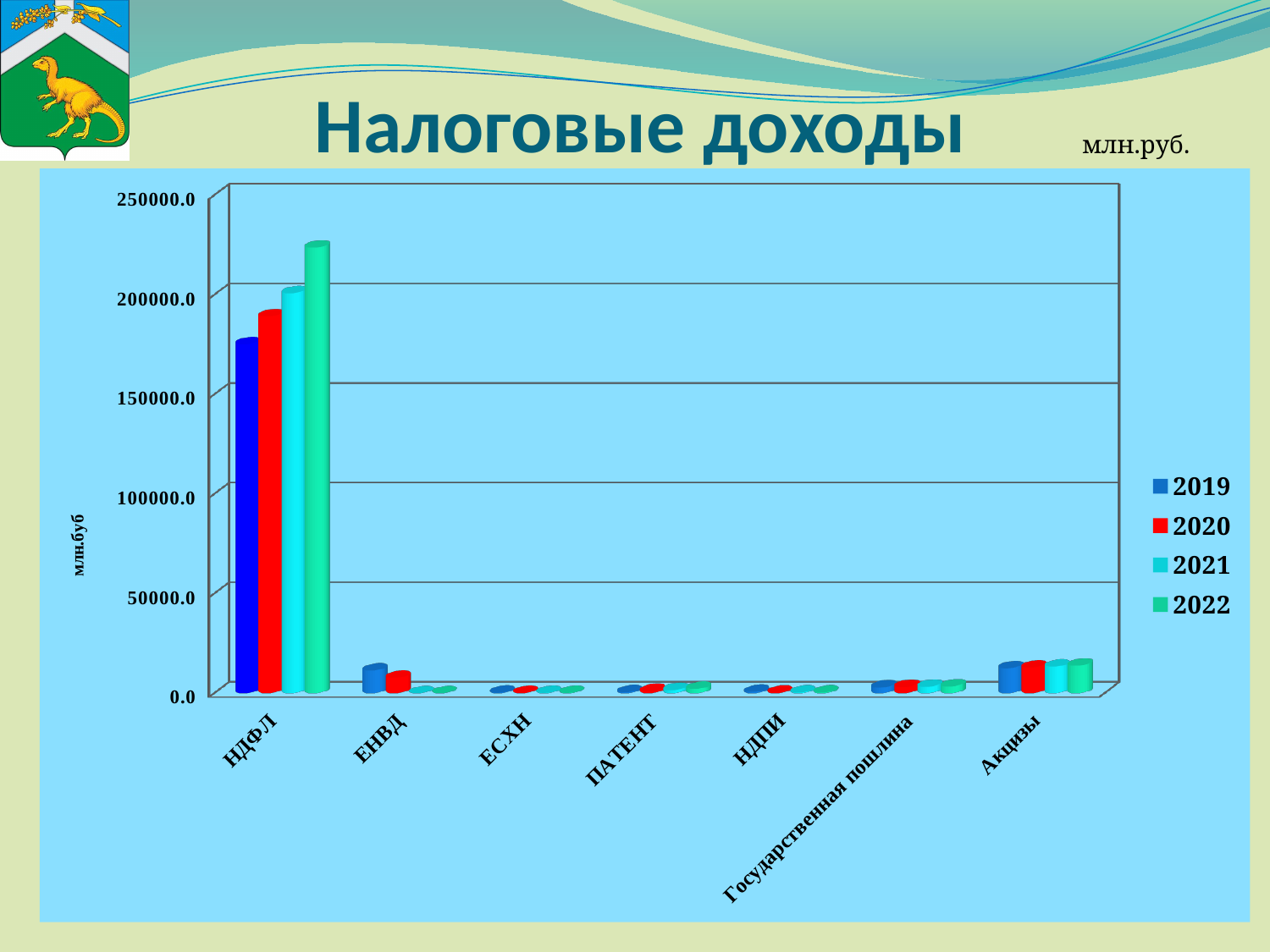
Which category has the highest values in the chart? НДФЛ Is the value for НДФЛ in 2022 greater or less than 200000.0? greater For НДФЛ, which is larger: the value for 2019 or the value for 2022? 2022 Is the value for НДФЛ in 2019 greater or less than 200000.0? less For ЕНВД, which is larger: the value for 2019 or the value for 2021? 2019 Do the values for НДФЛ rise or fall from 2019 to 2022? rise What kind of chart is shown on the slide? bar chart What is the title of the chart? Налоговые доходы How many categories are shown on the x axis of the chart? 7 Is the value for НДФЛ in 2019 greater or less than 150000.0? greater How many series does the legend list? 4